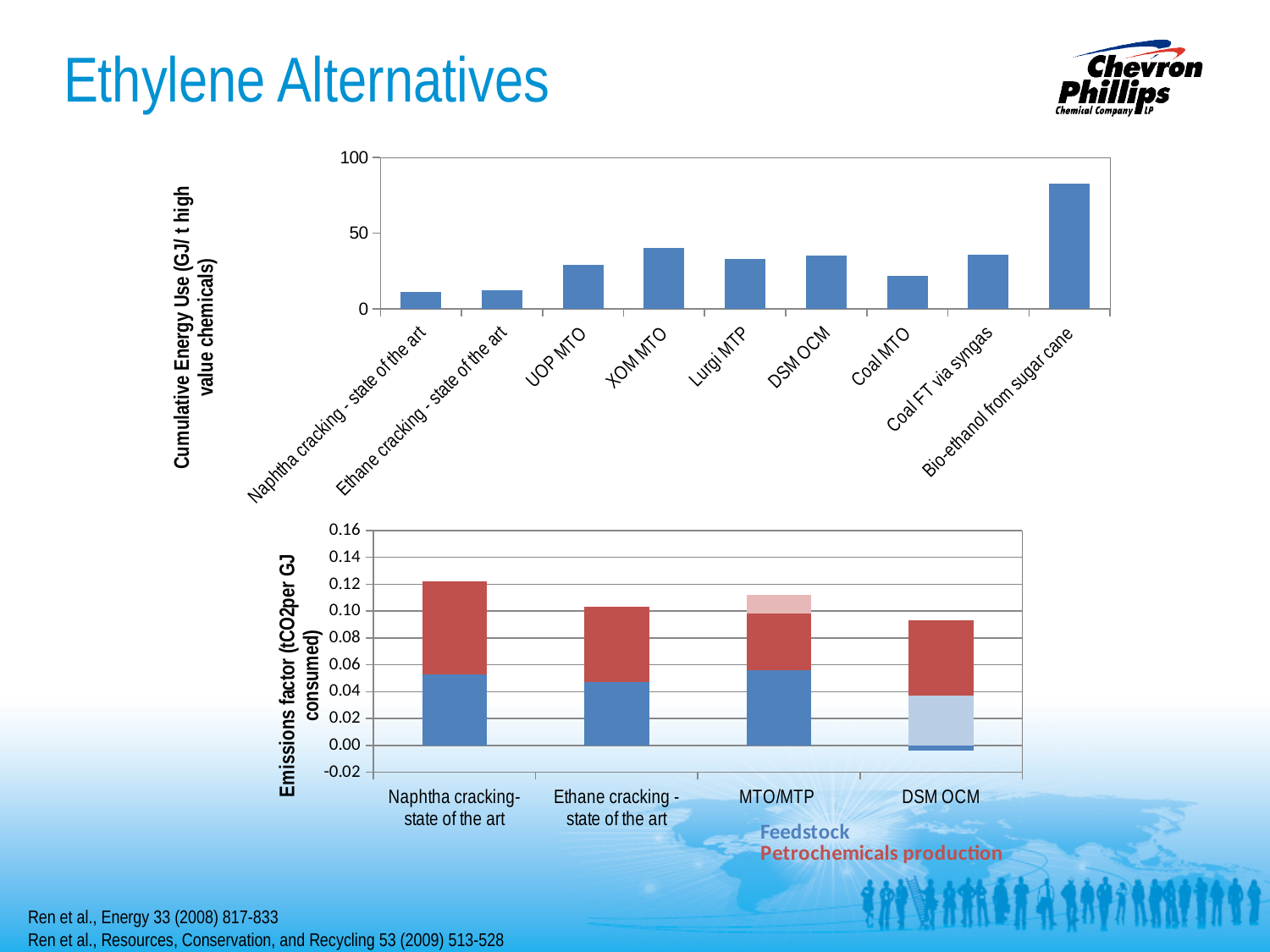
In the top chart (Cumulative Energy Use), is the value for Bio-ethanol from sugar cane greater or less than 50? greater In the bottom chart (Emissions factor), is the total for Naphtha cracking - state of the art greater or less than 0.10? greater What kind of chart is the bottom chart (Emissions factor)? stacked bar chart In the bottom chart (Emissions factor), how many series does the legend list? 2 In the top chart (Cumulative Energy Use), which is larger, the value for XOM MTO or the value for Coal MTO? XOM MTO In the top chart (Cumulative Energy Use), which category has the highest value? Bio-ethanol from sugar cane In the top chart (Cumulative Energy Use), which is larger, the value for Bio-ethanol from sugar cane or the value for DSM OCM? Bio-ethanol from sugar cane In the top chart (Cumulative Energy Use), how many categories are shown on the x axis? 9 In the bottom chart (Emissions factor), how many categories are shown on the x axis? 4 In the top chart (Cumulative Energy Use), is the value for UOP MTO greater or less than 50? less In the bottom chart (Emissions factor), what are the two series named in the legend? Feedstock and Petrochemicals production What kind of chart is the top chart (Cumulative Energy Use)? bar chart